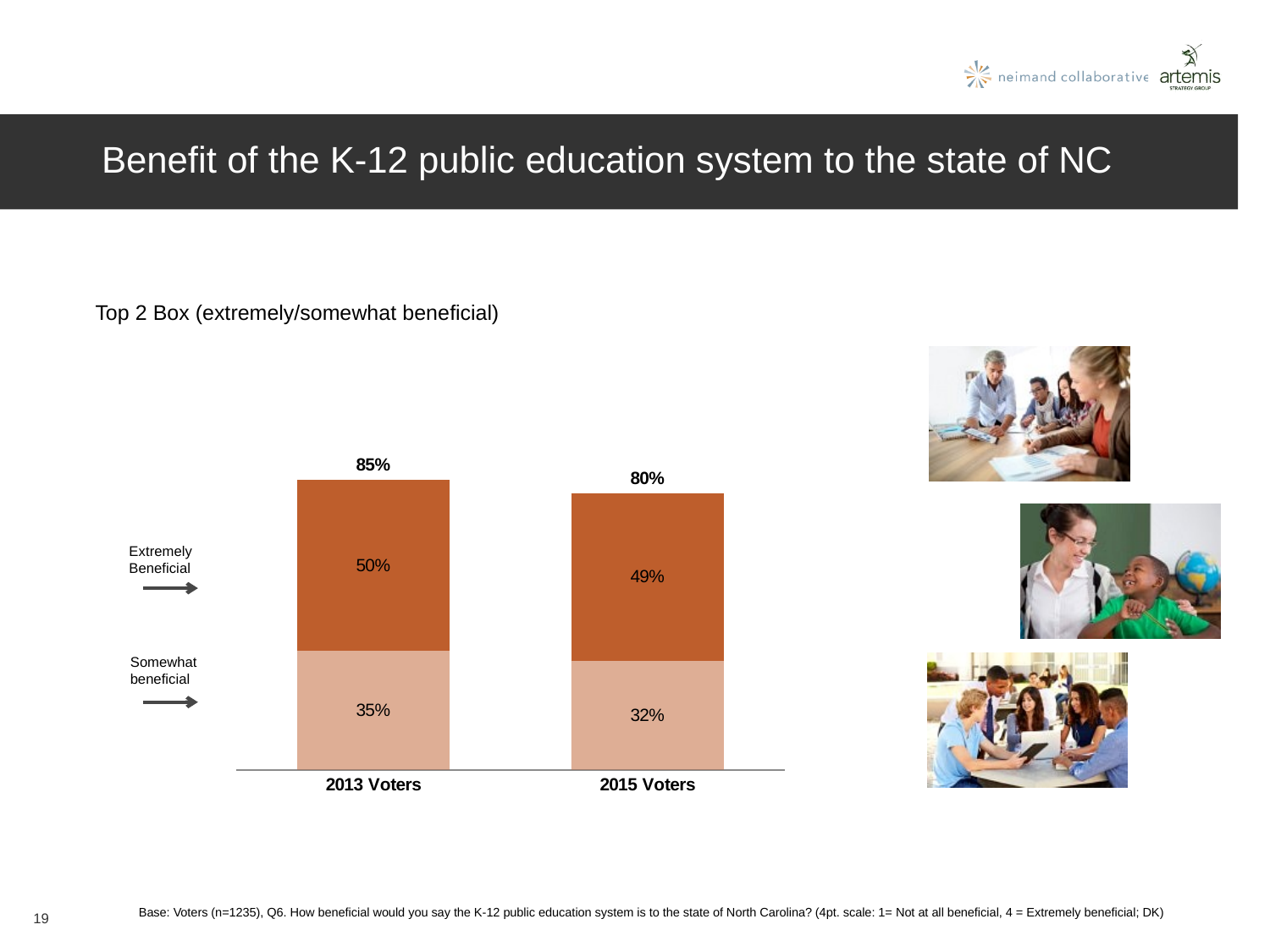
Which response category is shown in the darker orange segment of the bars? Extremely Beneficial What percentage of 2015 Voters said the K-12 public education system is somewhat beneficial? 32% What is the difference between the somewhat beneficial percentages for 2013 Voters and 2015 Voters? 3% How many voter groups are shown on the x axis of the chart? 2 Does the Top 2 Box total rise or fall from 2013 Voters to 2015 Voters? Fall What is the Top 2 Box total for 2015 Voters? 80% Which group has the lower extremely beneficial percentage? 2015 Voters What kind of chart is shown on the slide? Stacked bar chart What is the Top 2 Box total for 2013 Voters? 85% Which group has the higher Top 2 Box total, 2013 Voters or 2015 Voters? 2013 Voters What is the difference between the Top 2 Box totals for 2013 Voters and 2015 Voters? 5% What percentage of 2013 Voters said the K-12 public education system is extremely beneficial? 50%